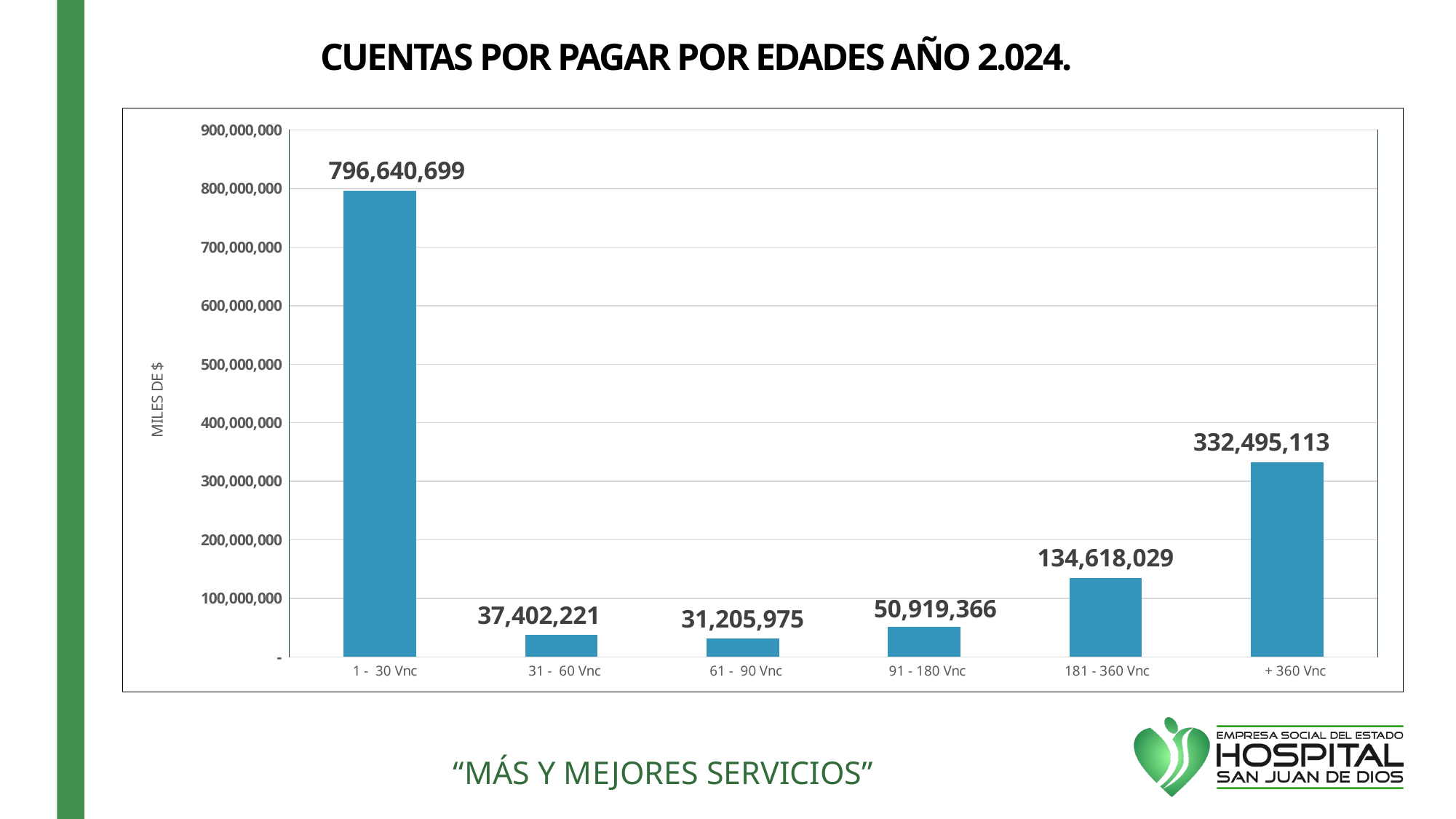
What is the value for the 181 - 360 Vnc category? 134,618,029 How many categories are shown on the x axis? 6 What is the value for the + 360 Vnc category? 332,495,113 Which is larger, the value for 181 - 360 Vnc or the value for 91 - 180 Vnc? 181 - 360 Vnc Which category has the highest value? 1 - 30 Vnc What is the label of the vertical axis? MILES DE $ What is the difference between the values for 31 - 60 Vnc and 61 - 90 Vnc? 6,196,246 What kind of chart is shown on the slide? Bar chart What is the value for the 91 - 180 Vnc category? 50,919,366 What is the difference between the values for 1 - 30 Vnc and + 360 Vnc? 464,145,586 Which category has the lowest value? 61 - 90 Vnc What is the value for the 1 - 30 Vnc category? 796,640,699